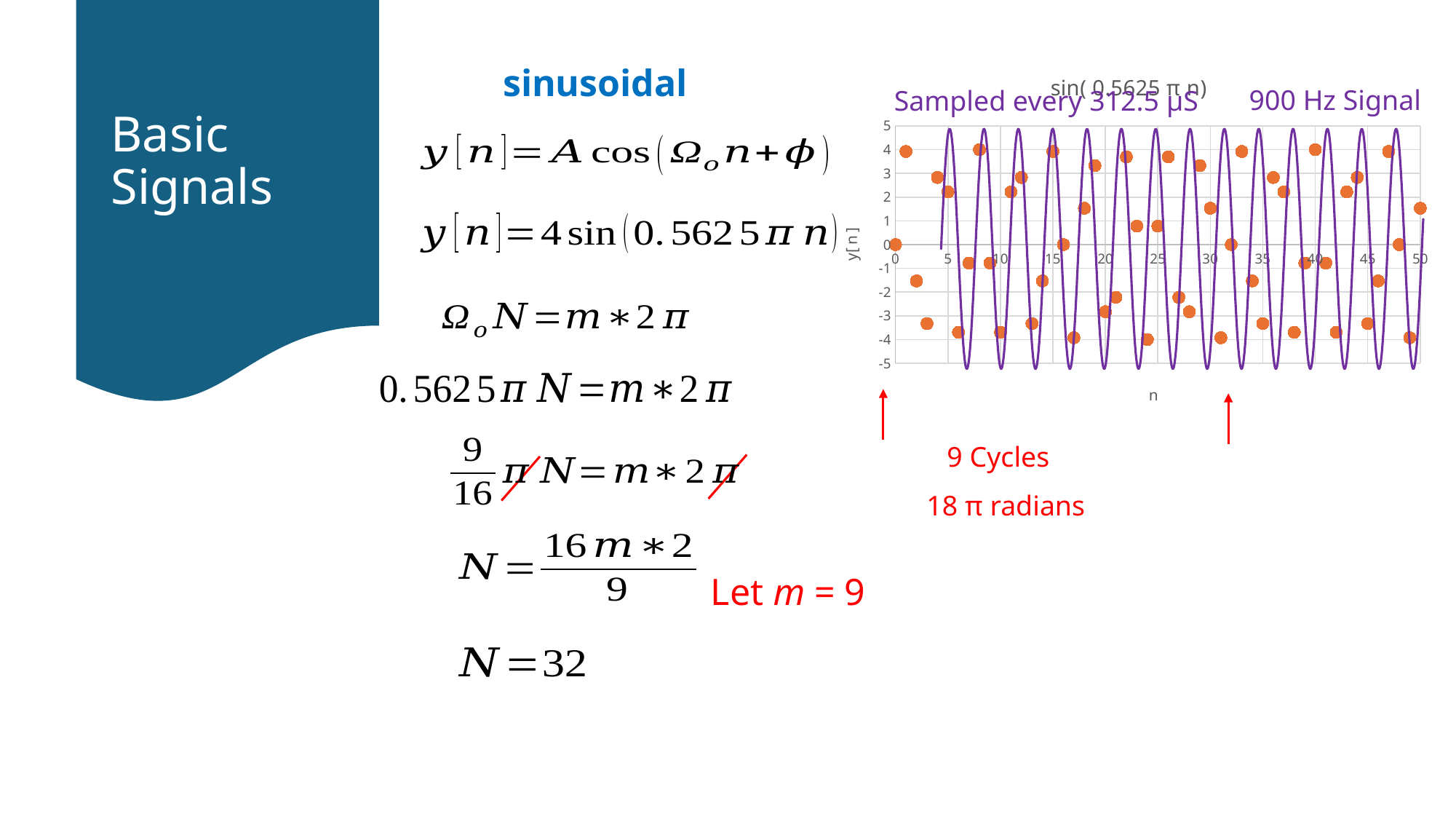
Which is larger, the sampled value at n = 1 or the sampled value at n = 2? n = 1 Is the sampled value at n = 1 greater or less than 3? greater What kind of chart is shown on the slide? line chart Is the sampled value at n = 2 greater or less than 0? less What is the sampled value y[n] at n = 0 in the chart? 0 Is the sampled value at n = 4 greater or less than 2? greater What is the largest value shown on the horizontal axis of the chart? 50 What is the title of the chart? sin( 0.5625 π n) What is the label of the horizontal axis of the chart? n What is the lowest value shown on the vertical axis of the chart? -5 What is the highest value shown on the vertical axis of the chart? 5